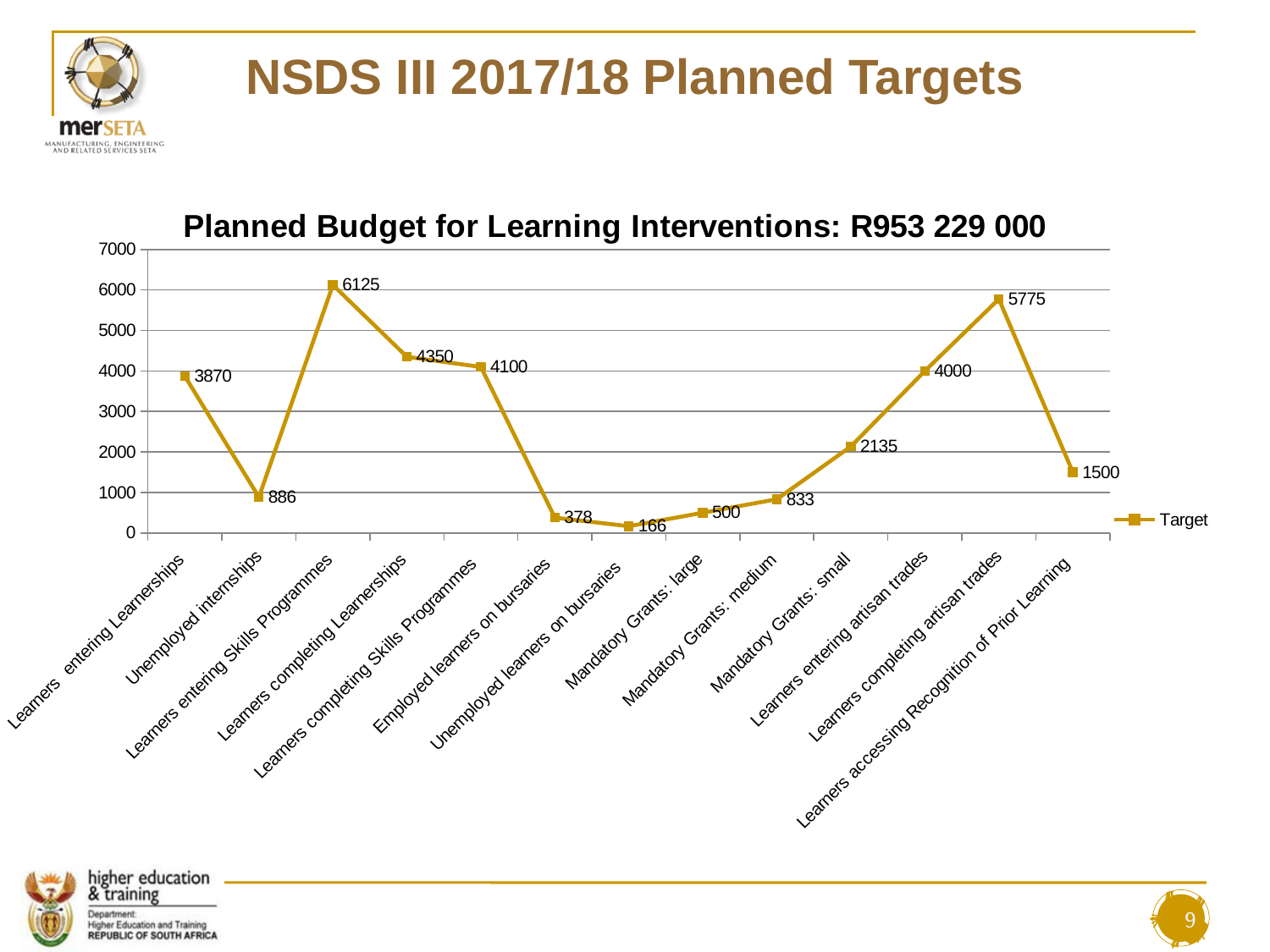
What is the Target value for Unemployed internships? 886 What is the Target value for Mandatory Grants: small? 2135 Is the Target value for Learners accessing Recognition of Prior Learning greater or less than 2000? less How many series does the legend list? 1 Which has a larger Target value: Learners entering Learnerships or Learners entering artisan trades? Learners entering artisan trades Which category has the lowest Target value? Unemployed learners on bursaries How many categories are plotted on the x axis? 13 What is the Target value for Learners completing artisan trades? 5775 What is the difference between the Target values for Learners completing Learnerships and Learners completing Skills Programmes? 250 What kind of chart is shown on the slide? line chart Which category has the highest Target value? Learners entering Skills Programmes What is the Target value for Learners entering Skills Programmes? 6125